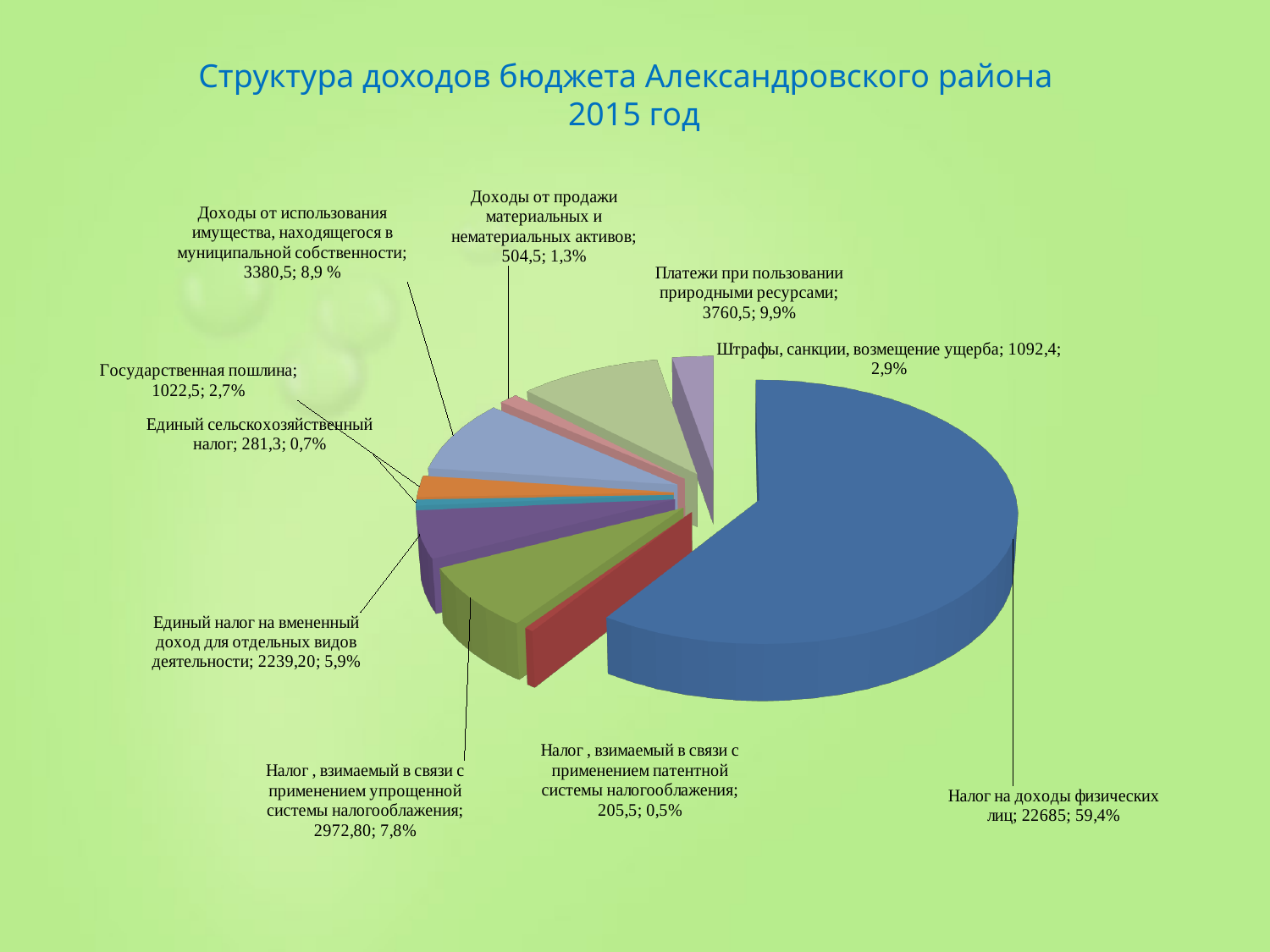
What value is shown for "Единый сельскохозяйственный налог"? 281,3 What is the title of the chart? Структура доходов бюджета Александровского района 2015 год Which category has the smallest slice of the pie? Налог, взимаемый в связи с применением патентной системы налогообложения What is the difference between the values for "Платежи при пользовании природными ресурсами" and "Доходы от использования имущества, находящегося в муниципальной собственности"? 380 How many categories (slices) does the pie chart have? 10 What share of the pie does "Единый налог на вмененный доход для отдельных видов деятельности" have? 5,9% Which is larger: "Государственная пошлина" or "Штрафы, санкции, возмещение ущерба"? Штрафы, санкции, возмещение ущерба What share of the pie does "Налог на доходы физических лиц" have? 59,4% What value is shown for "Платежи при пользовании природными ресурсами"? 3760,5 What value is shown for "Налог на доходы физических лиц"? 22685 What kind of chart is shown on the slide? pie chart Which category has the largest slice of the pie? Налог на доходы физических лиц